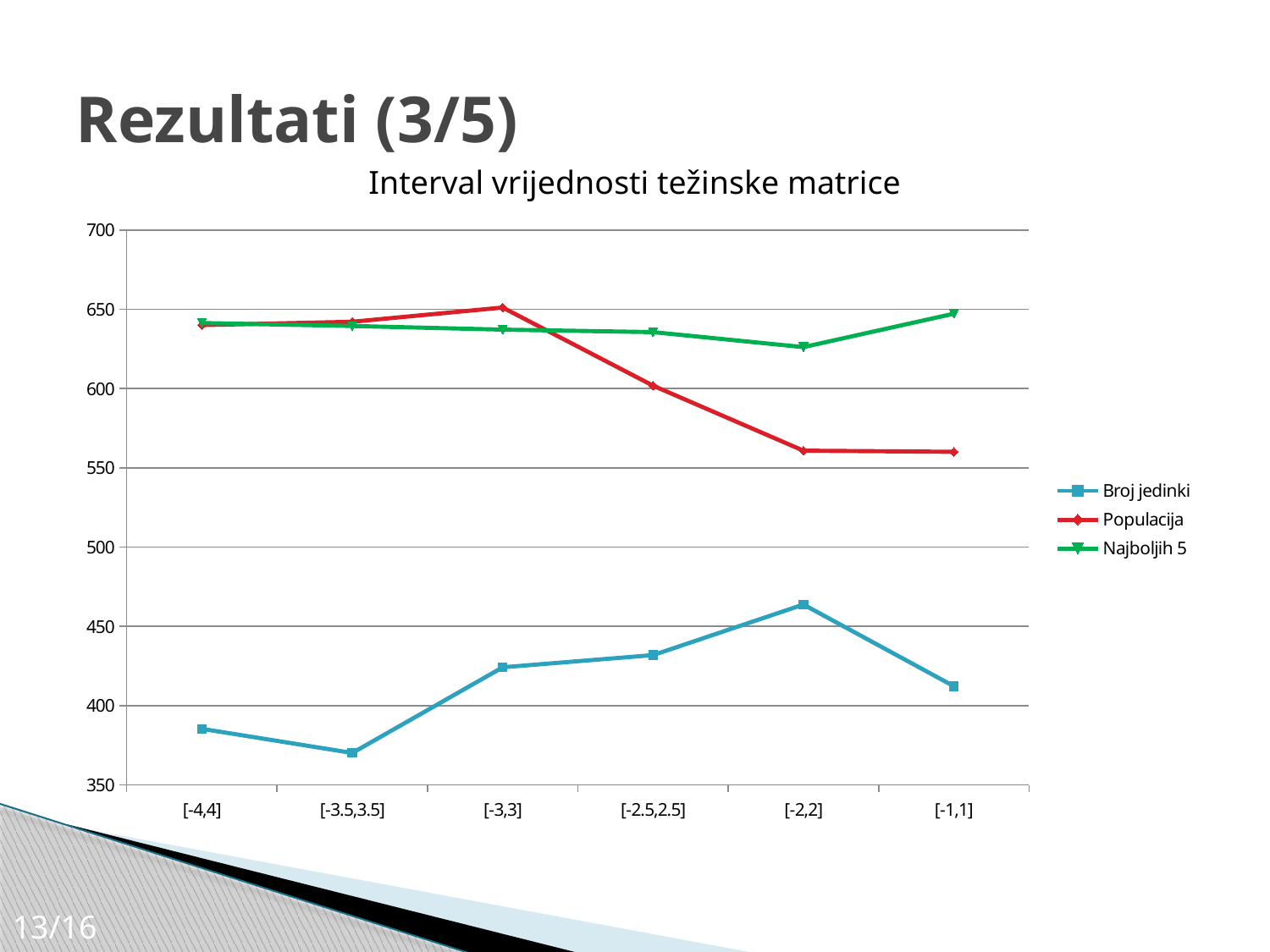
For which category is the Najboljih 5 series lowest? [-2,2] What kind of chart is shown on the slide? line chart Is the value of Populacija for [-1,1] greater or less than 600? less Does the Populacija series rise or fall overall from [-4,4] to [-1,1]? fall How many categories are shown on the x axis? 6 At [-2,2], which series has the larger value, Populacija or Najboljih 5? Najboljih 5 For which category is the Broj jedinki series highest? [-2,2] For which category is the Broj jedinki series lowest? [-3.5,3.5] Is the value of Broj jedinki for [-2,2] greater or less than 450? greater How many series does the legend list? 3 Is the value of Broj jedinki for [-3.5,3.5] greater or less than 400? less What is the title of the chart? Interval vrijednosti težinske matrice